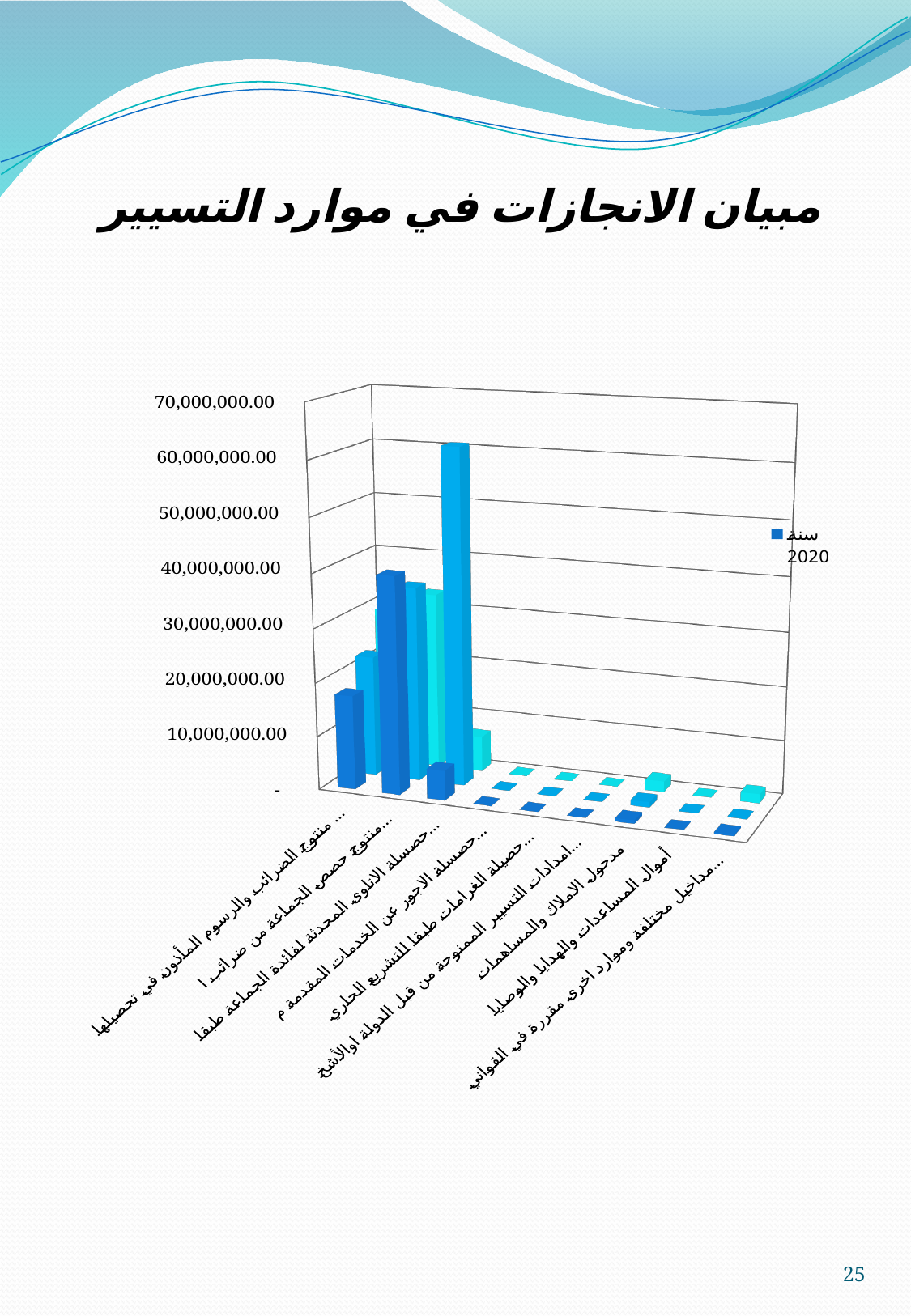
Is the value of the tallest bar in the chart greater or less than 50,000,000.00? greater Are the bars at the right-hand end of the chart (مداخيل مختلفة وموارد اخرى) greater or less than 10,000,000.00? less Is the value of the first bar (منتوج الضرائب والرسوم) greater or less than 30,000,000.00? less What is the highest value shown on the vertical axis of the chart? 70,000,000.00 What kind of chart is shown on the slide? bar chart What is the legend entry of the chart? سنة 2020 What is the title of the chart on the slide? مبيان الانجازات في موارد التسيير